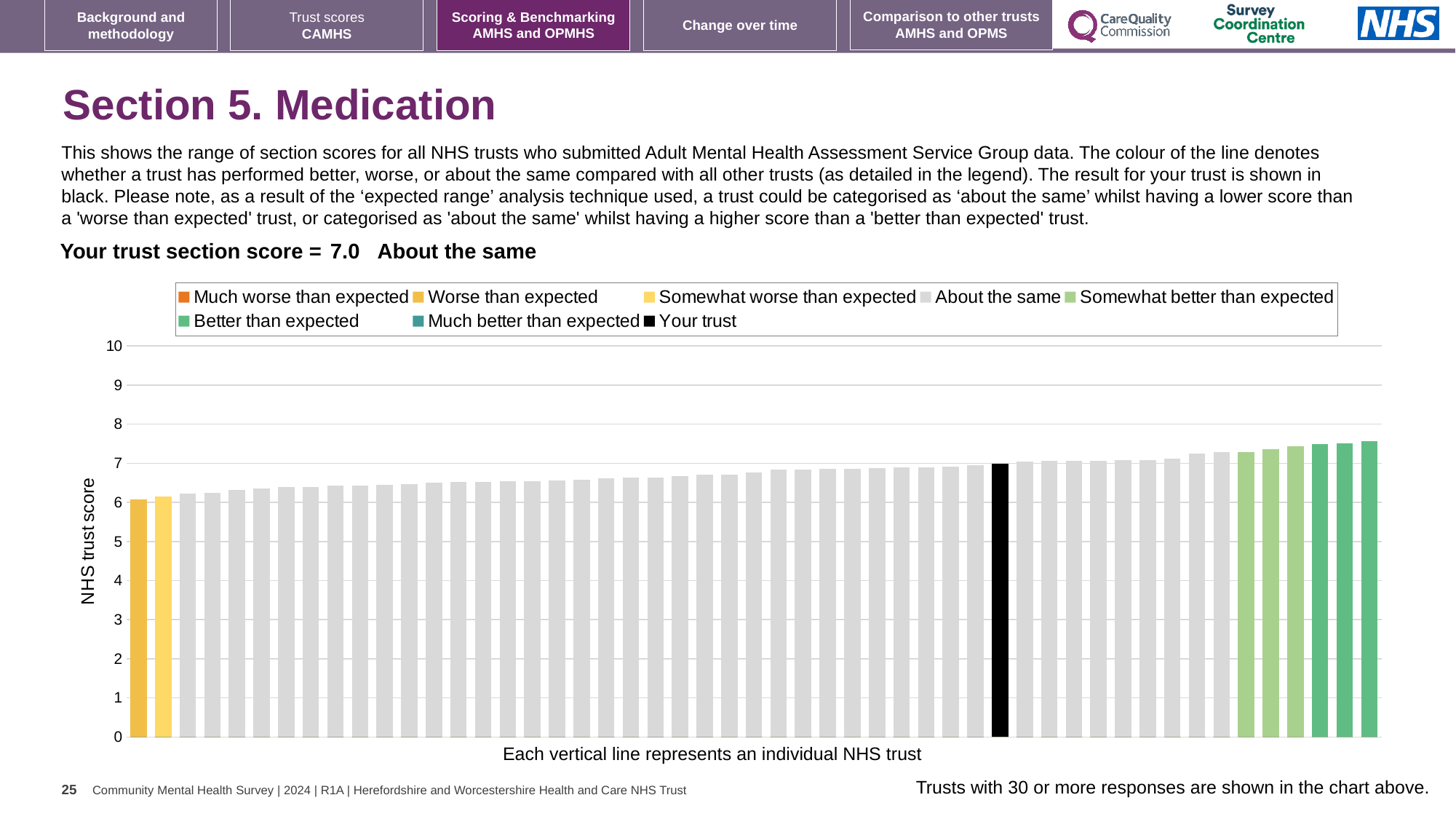
How many bars are coloured as 'Somewhat better than expected' (the light green bars)? 3 How many entries does the chart legend list? 8 Do the bar values rise or fall from left to right across the chart? rise Is the value of the lowest bar in the chart greater or less than 7? less Which category is your trust placed in for this section? About the same What is the section score for your trust shown on the slide? 7.0 What kind of chart is shown on the slide? bar chart How many bars are coloured as 'Better than expected' (the darker green bars)? 3 What is the label on the vertical axis of the chart? NHS trust score What colour is the bar representing your trust? black Is the value of the highest bar in the chart greater or less than 8? less Is the value of the black 'Your trust' bar greater or less than 6? greater